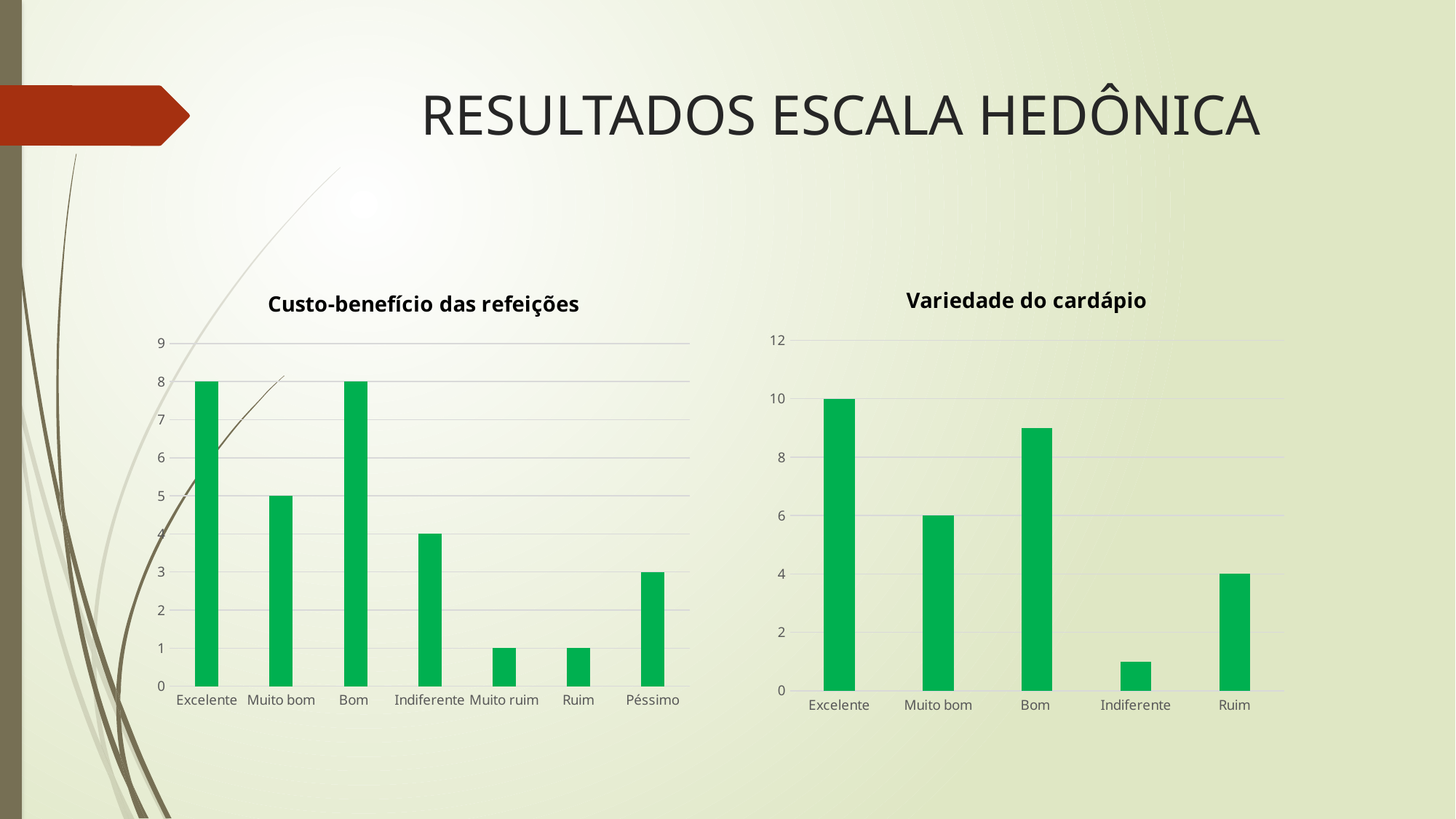
In the 'Variedade do cardápio' chart, what is the value for Excelente? 10 In the 'Custo-benefício das refeições' chart, what is the value for Péssimo? 3 In the 'Variedade do cardápio' chart, what is the value for Muito bom? 6 In the 'Custo-benefício das refeições' chart, which is larger, the value for Muito bom or the value for Péssimo? Muito bom In the 'Variedade do cardápio' chart, how many categories are shown on the x axis? 5 In the 'Custo-benefício das refeições' chart, what is the value for Excelente? 8 In the 'Custo-benefício das refeições' chart, how many categories are shown on the x axis? 7 In the 'Custo-benefício das refeições' chart, what is the value for Muito bom? 5 In the 'Custo-benefício das refeições' chart, what is the difference between the values for Bom and Indiferente? 4 What type of chart is the 'Variedade do cardápio' chart? Bar chart In the 'Variedade do cardápio' chart, is the value for Bom greater or less than 8? greater In the 'Variedade do cardápio' chart, which category has the lowest value? Indiferente